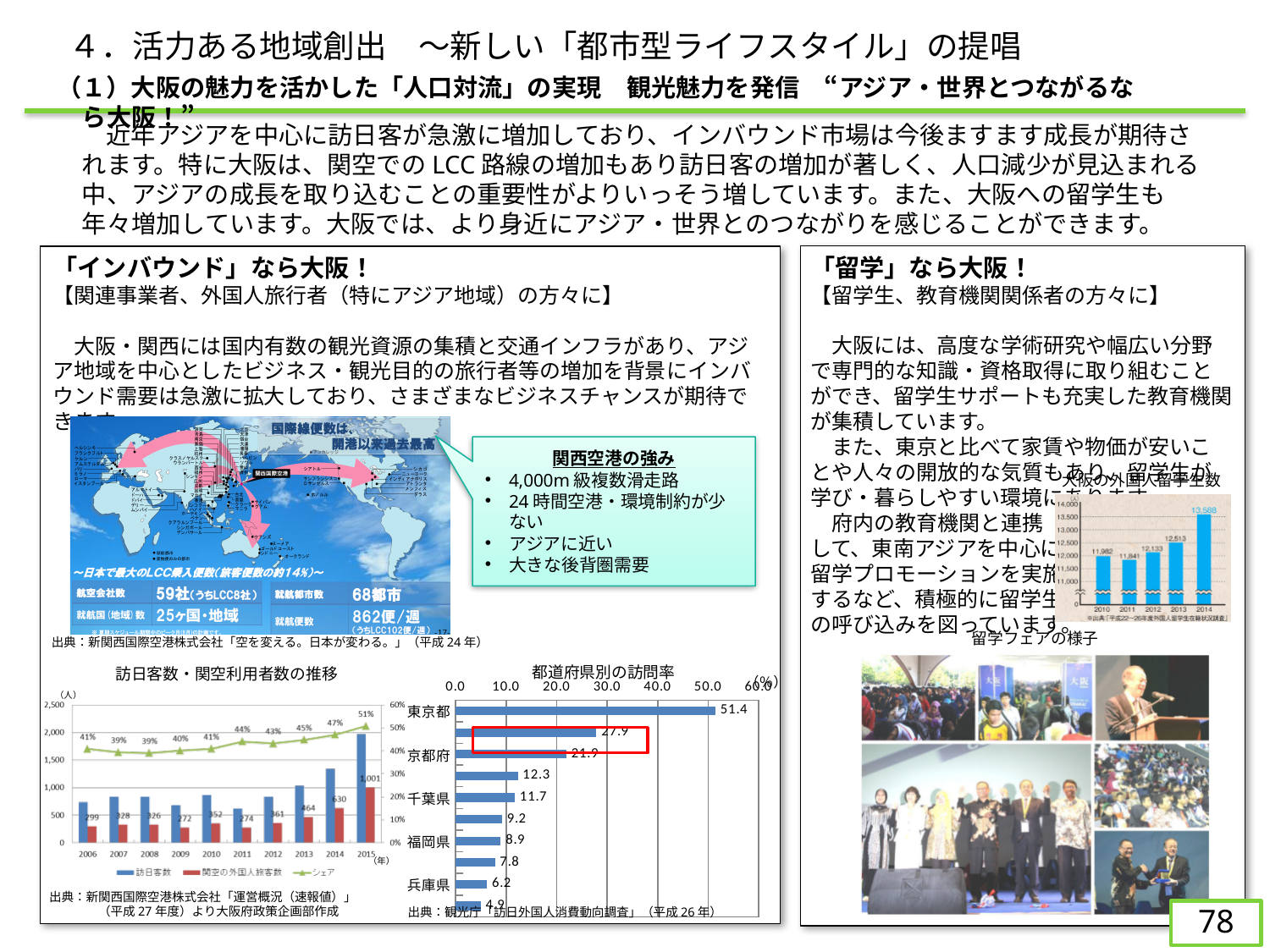
In the 都道府県別の訪問率 chart, what is the value for 東京都? 51.4 How many bars are plotted in the 都道府県別の訪問率 chart? 10 In the 訪日客数・関空利用者数の推移 chart, what is the value of 関空の外国人旅客数 for 2015? 1,001 What kind of chart is the 都道府県別の訪問率 chart? bar chart In the 都道府県別の訪問率 chart, what is the value for 千葉県? 11.7 In the 都道府県別の訪問率 chart, which has the larger value, 福岡県 or 兵庫県? 福岡県 In the 訪日客数・関空利用者数の推移 chart, what is the シェア value for 2015? 51% In the 都道府県別の訪問率 chart, which prefecture has the highest visit rate? 東京都 In the 都道府県別の訪問率 chart, what is the difference between the values for 東京都 and 京都府? 29.5 In the 都道府県別の訪問率 chart, what is the value for 京都府? 21.9 How many series does the legend of the 訪日客数・関空利用者数の推移 chart list? 3 In the 訪日客数・関空利用者数の推移 chart, does 関空の外国人旅客数 rise or fall from 2012 to 2015? rise